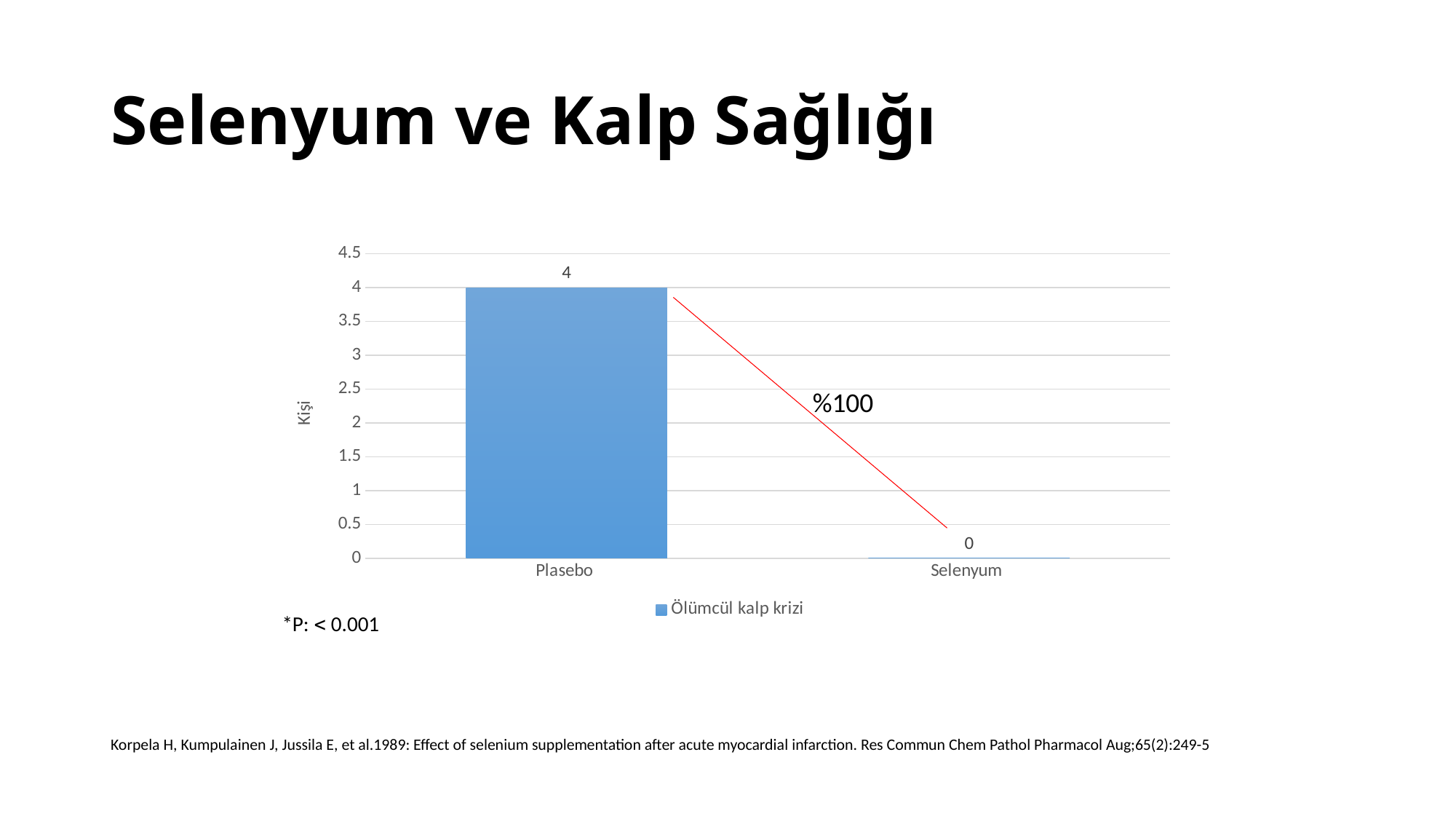
What is the difference between the values for Plasebo and Selenyum? 4 Which is larger, the value for Plasebo or the value for Selenyum? Plasebo Is the value for Plasebo greater or less than 3? greater What is the value for Plasebo? 4 What kind of chart is shown on the slide? bar chart Which category has the highest value? Plasebo What is the label on the y axis? Kişi What is the name of the series in the legend? Ölümcül kalp krizi How many series does the legend list? 1 What is the value for Selenyum? 0 Which category has the lowest value? Selenyum How many categories are shown on the x axis? 2